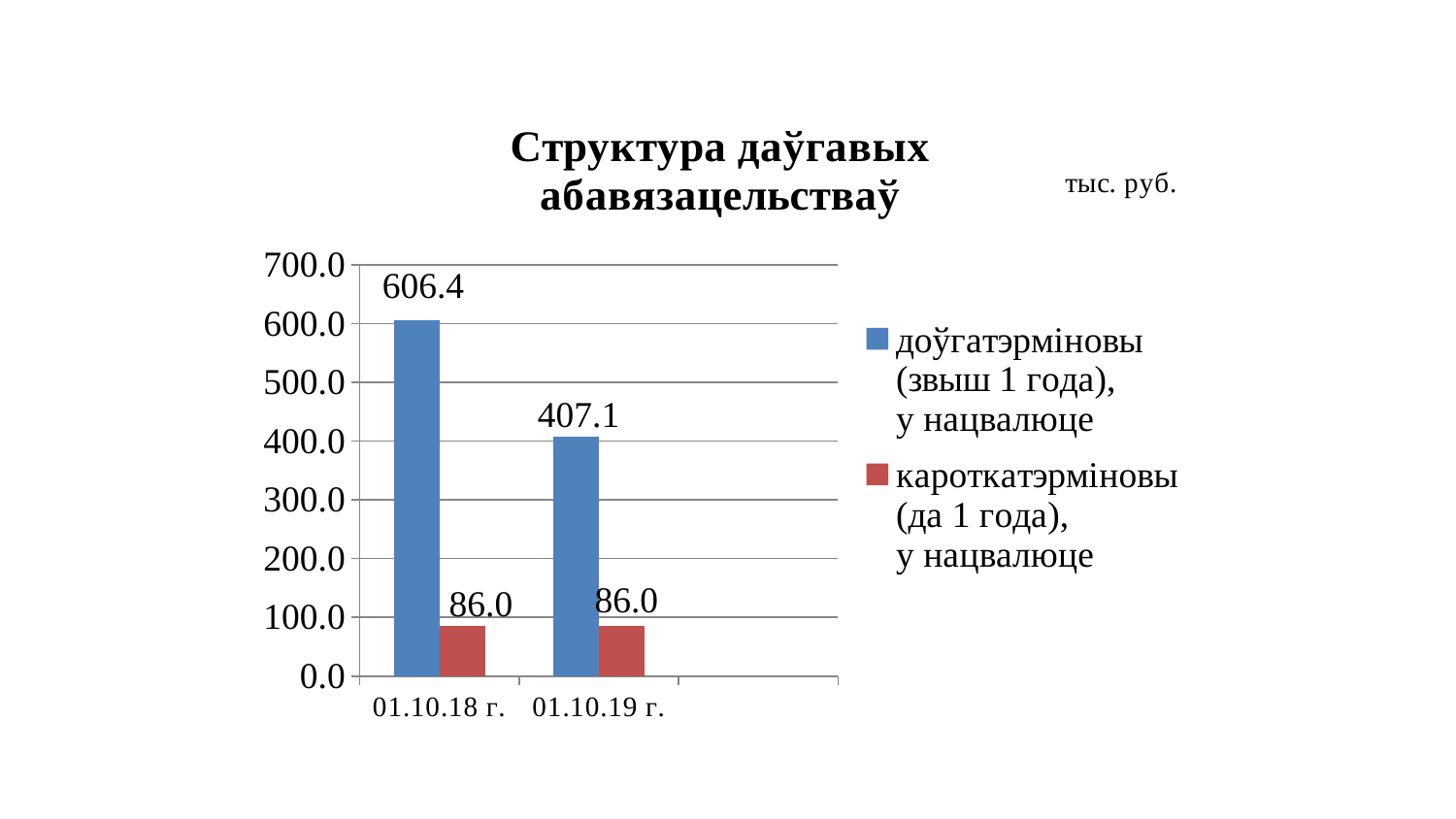
How many series does the legend list? 2 What type of chart is shown on the slide? bar chart How many dates (categories) are shown on the x axis? 2 What is the value of the long-term (доўгатэрміновы) series for 01.10.18 г.? 606.4 What is the value of the short-term (кароткатэрміновы) series for 01.10.18 г.? 86.0 Which date has the higher value for the long-term (доўгатэрміновы) series? 01.10.18 г. What is the value of the short-term (кароткатэрміновы) series for 01.10.19 г.? 86.0 What is the difference between the long-term and short-term values for 01.10.19 г.? 321.1 What is the difference between the long-term values for 01.10.18 г. and 01.10.19 г.? 199.3 Which is larger for 01.10.18 г.: the long-term value or the short-term value? long-term (доўгатэрміновы) Does the long-term value for 01.10.19 г. rise or fall compared with 01.10.18 г.? fall What is the value of the long-term (доўгатэрміновы) series for 01.10.19 г.? 407.1